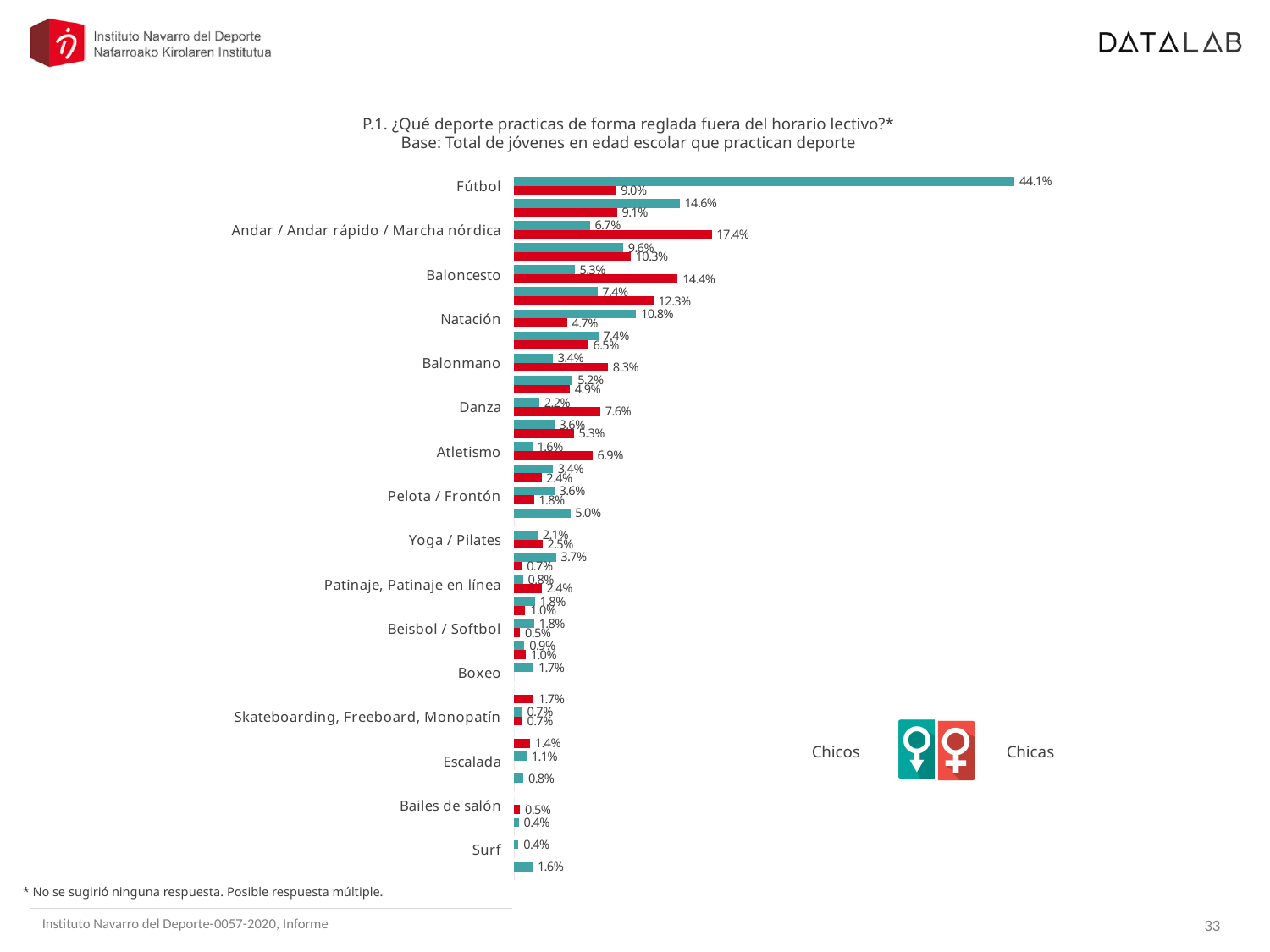
What kind of chart is shown on the slide? bar chart What is the value for Chicas in the Fútbol category? 9.0% What is the value for Chicas in the Balonmano category? 8.3% What is the difference between the Chicos and Chicas values for Fútbol? 35.1 percentage points For Natación, which series has the larger value, Chicos or Chicas? Chicos What is the value for Chicos in the Atletismo category? 1.6% What is the value for Chicas in the Danza category? 7.6% How many series does the chart's legend list? 2 What are the two series named in the legend? Chicos and Chicas What is the value for Chicos in the Fútbol category? 44.1% What is the value for Chicas in the Andar / Andar rápido / Marcha nórdica category? 17.4% Which category has the highest value in the whole chart? Fútbol